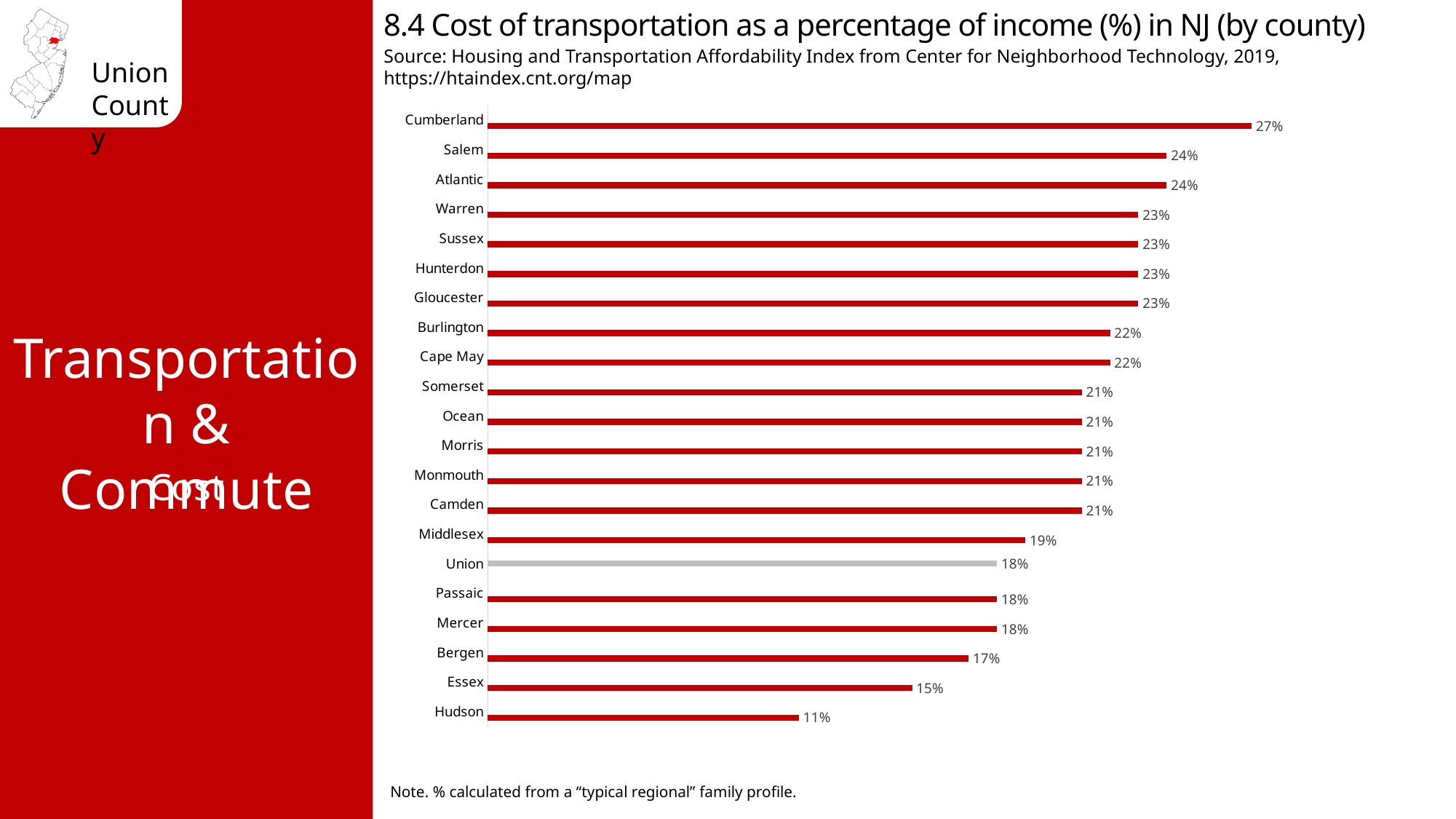
What is the difference between the values for Union and Essex? 3% Which county has the lowest cost of transportation as a percentage of income? Hudson What kind of chart is shown on the slide? Bar chart What is the cost of transportation as a percentage of income for Union County? 18% What is the value shown for Salem County? 24% What is the difference between the values for Cumberland and Hudson? 16% How many counties are shown in the chart? 21 Which county's bar is shown in a different colour (grey) from the others? Union What is the cost of transportation as a percentage of income for Hudson County? 11% Which county has the highest cost of transportation as a percentage of income? Cumberland Which has a higher value, Bergen or Middlesex? Middlesex What is the value shown for Middlesex County? 19%